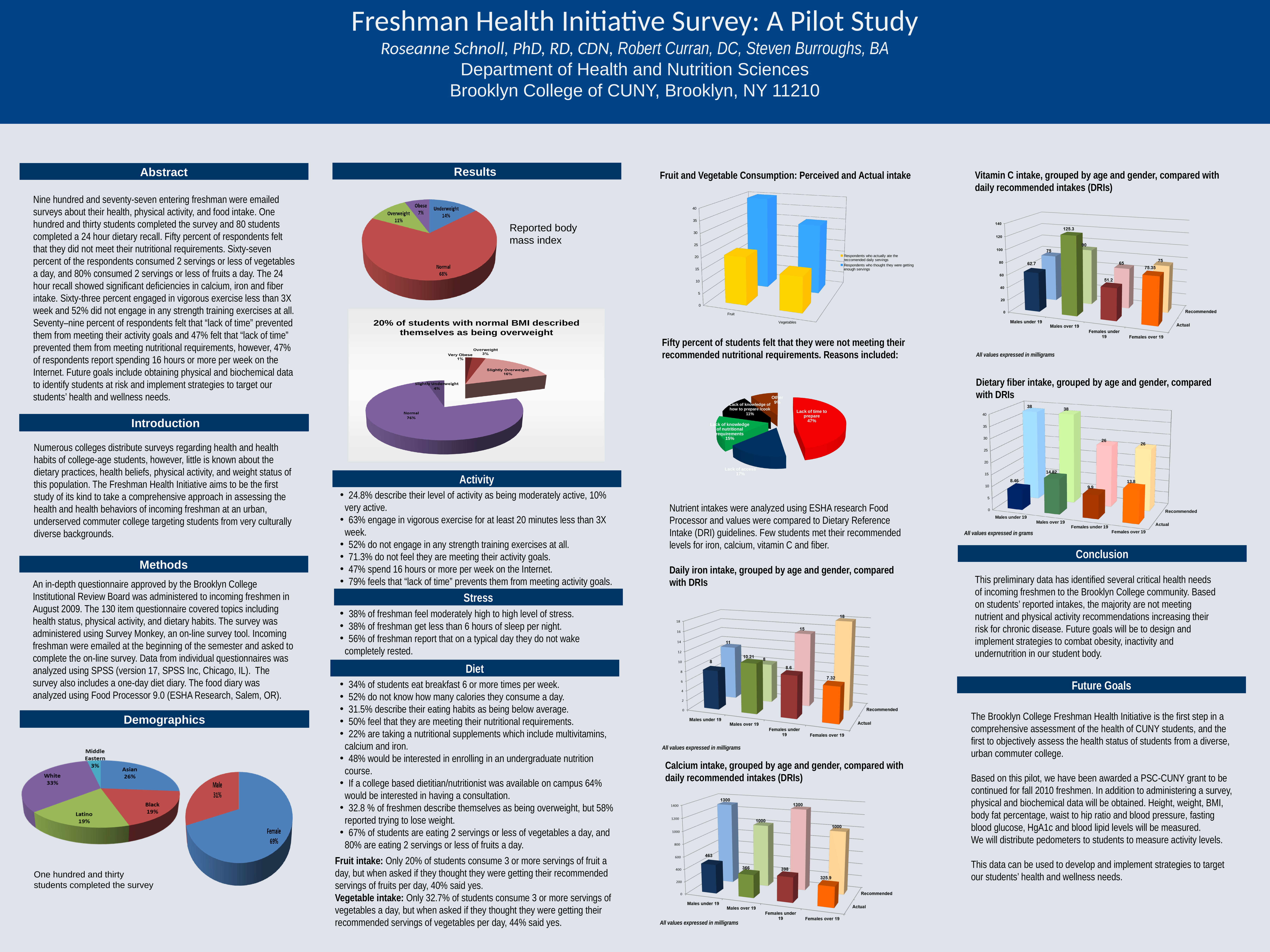
In the pie chart of reasons for not meeting nutritional requirements, what percentage is 'Lack of time to prepare'? 47% In the Demographics gender pie chart, what is the difference between the Female and Male percentages? 38% In the Demographics ethnicity pie chart, which group has the largest share? White In the 'Calcium intake' chart, what is the Actual value for Females over 19? 325.9 In the 'Fruit and Vegetable Consumption: Perceived and Actual intake' chart, how many series does the legend list? 2 In the 'Vitamin C intake' chart, is the Actual value for Males over 19 larger or smaller than the Recommended value for Males over 19? larger In the 'Reported body mass index' pie chart, which category has the smallest share? Obese In the pie chart titled '20% of students with normal BMI described themselves as being overweight', what share is labelled Slightly Overweight? 16% In the 'Vitamin C intake' chart, what is the Actual value for Males over 19? 125.3 In the 'Dietary fiber intake' chart, what is the difference between the Recommended and Actual values for Males under 19? 29.54 In the 'Reported body mass index' pie chart, what percentage of students are in the Normal category? 68% In the 'Daily iron intake' chart, which group has the lowest Actual value? Females over 19